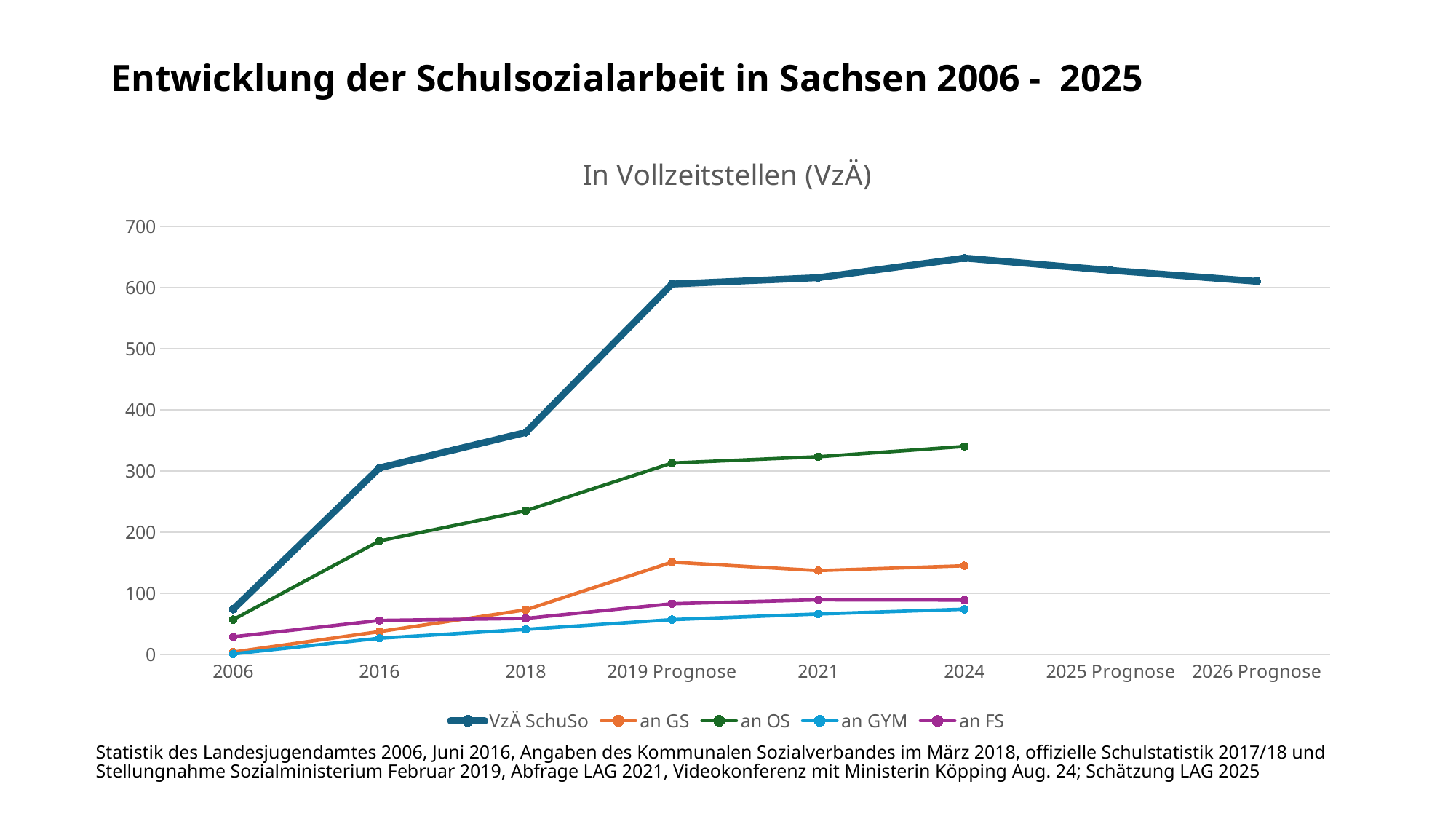
What is the subtitle shown above the chart? In Vollzeitstellen (VzÄ) How many series does the legend list? 5 How many categories are shown on the x axis? 8 Is the value for an GS in 2019 Prognose greater or less than 100? greater What kind of chart is shown on the slide? line chart Is the value for VzÄ SchuSo in 2018 greater or less than 400? less Is the value for VzÄ SchuSo in 2024 greater or less than 600? greater Which series has the highest value in 2024? VzÄ SchuSo Which series has the lowest value in 2021? an GYM In 2018, which is larger: the value for an OS or the value for an GS? an OS Does the VzÄ SchuSo line rise or fall from 2006 to 2024? rise